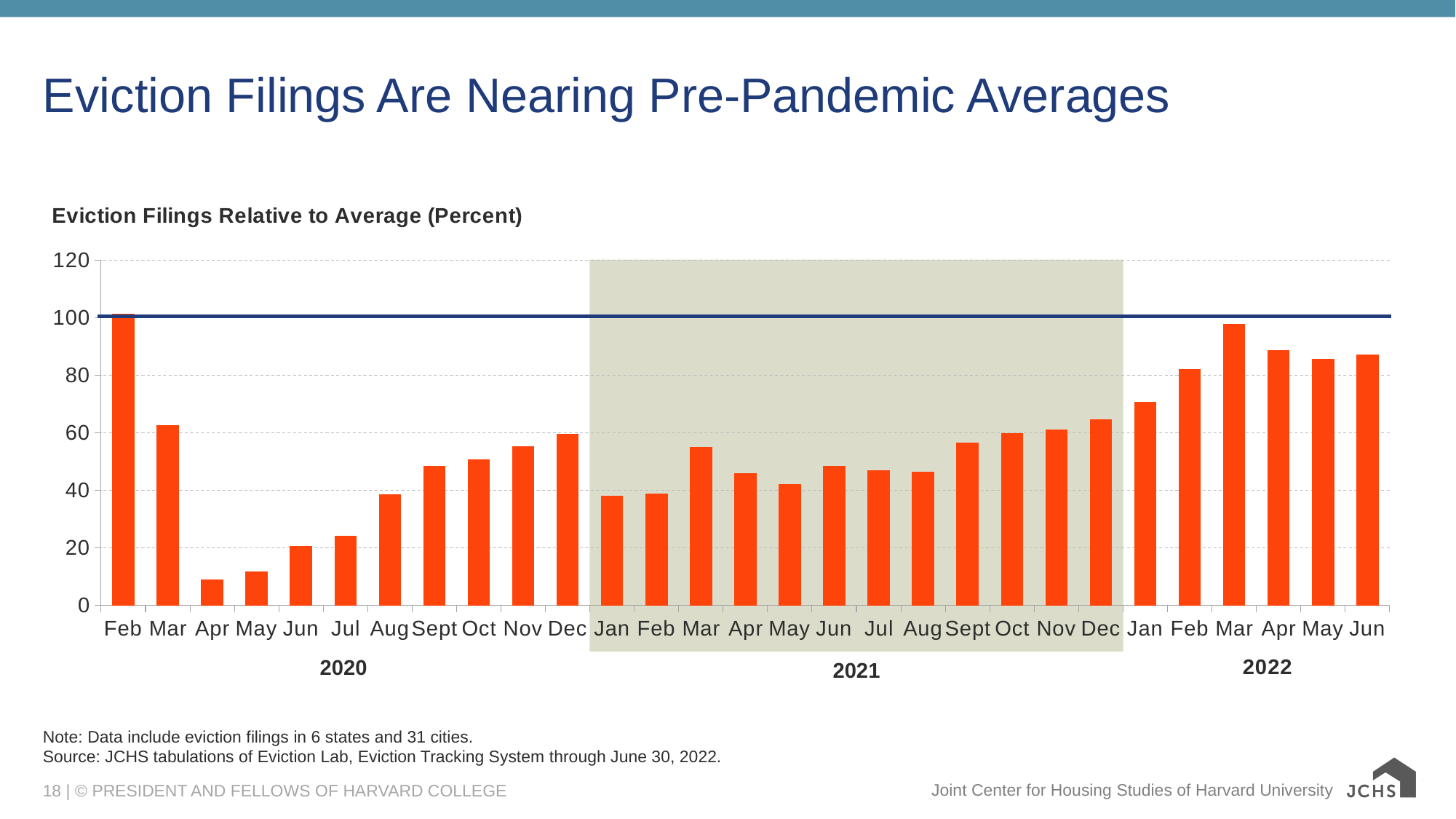
Which month has the highest value in the chart? Feb 2020 At what level on the y axis is the horizontal reference line drawn? 100 Is the value for Jun 2022 greater or less than 80? greater Which month has the lowest value in the chart? Apr 2020 Is the value for Apr 2020 greater or less than 20? less Which is larger, the value for Mar 2021 or the value for Mar 2022? Mar 2022 Is the value for Jun 2021 greater or less than 60? less Do the values rise or fall from Apr 2020 to Dec 2020? Rise How many monthly bars are plotted in the chart? 29 What kind of chart is shown on the slide? Bar chart Which is larger, the value for Dec 2020 or the value for Jan 2021? Dec 2020